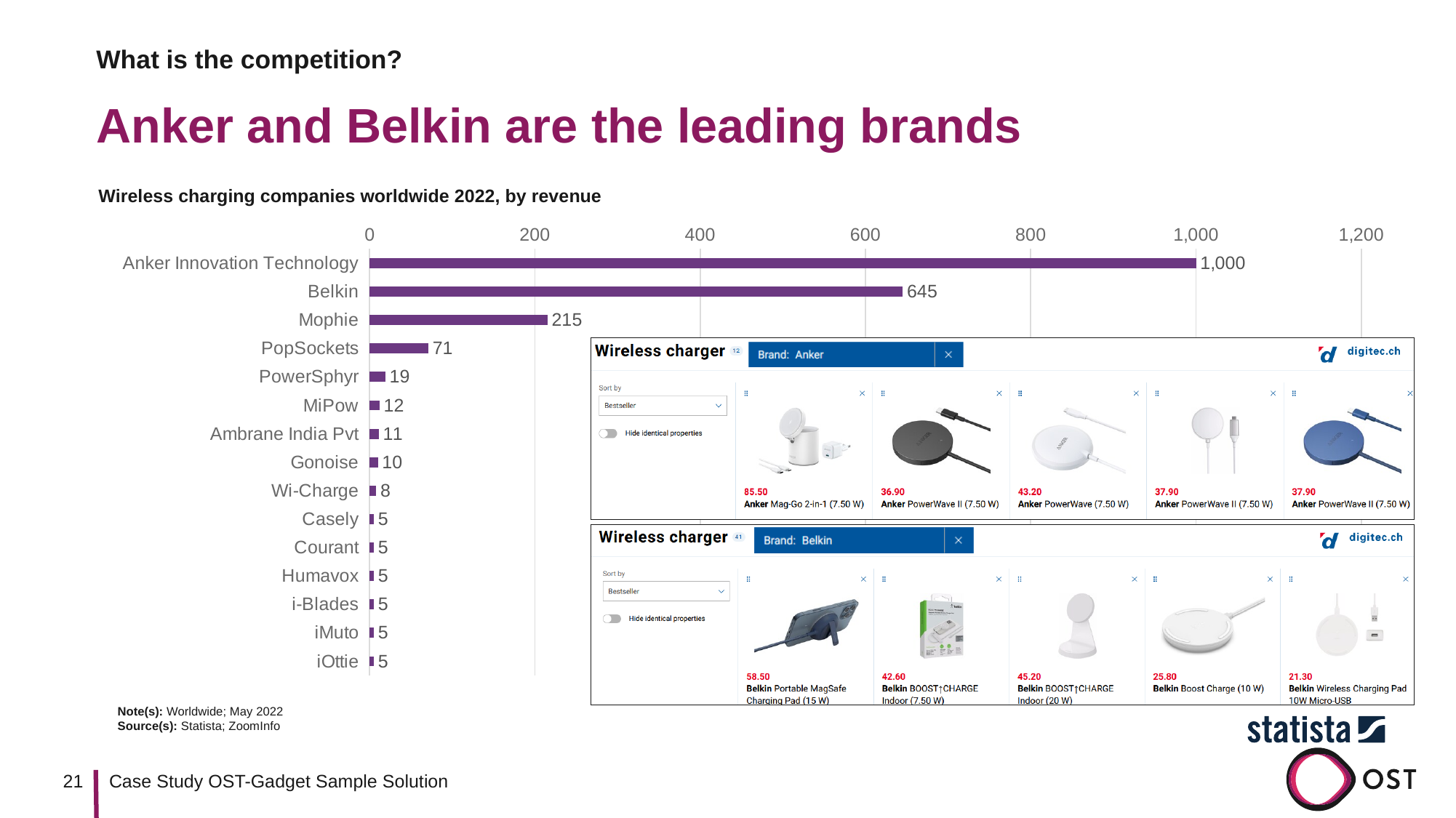
What is the value for Ambrane India Pvt? 11 What is the difference between the values for Anker Innovation Technology and Belkin? 355 What is the value for Mophie? 215 What is the difference between the values for Mophie and PopSockets? 144 Which company has the highest value? Anker Innovation Technology Which is larger, the value for PowerSphyr or the value for MiPow? PowerSphyr What is the value for Belkin? 645 What is the value for Anker Innovation Technology? 1,000 What kind of chart is shown on the slide? Bar chart How many companies are shown in the chart? 15 What is the title of the chart? Wireless charging companies worldwide 2022, by revenue What is the value for PopSockets? 71